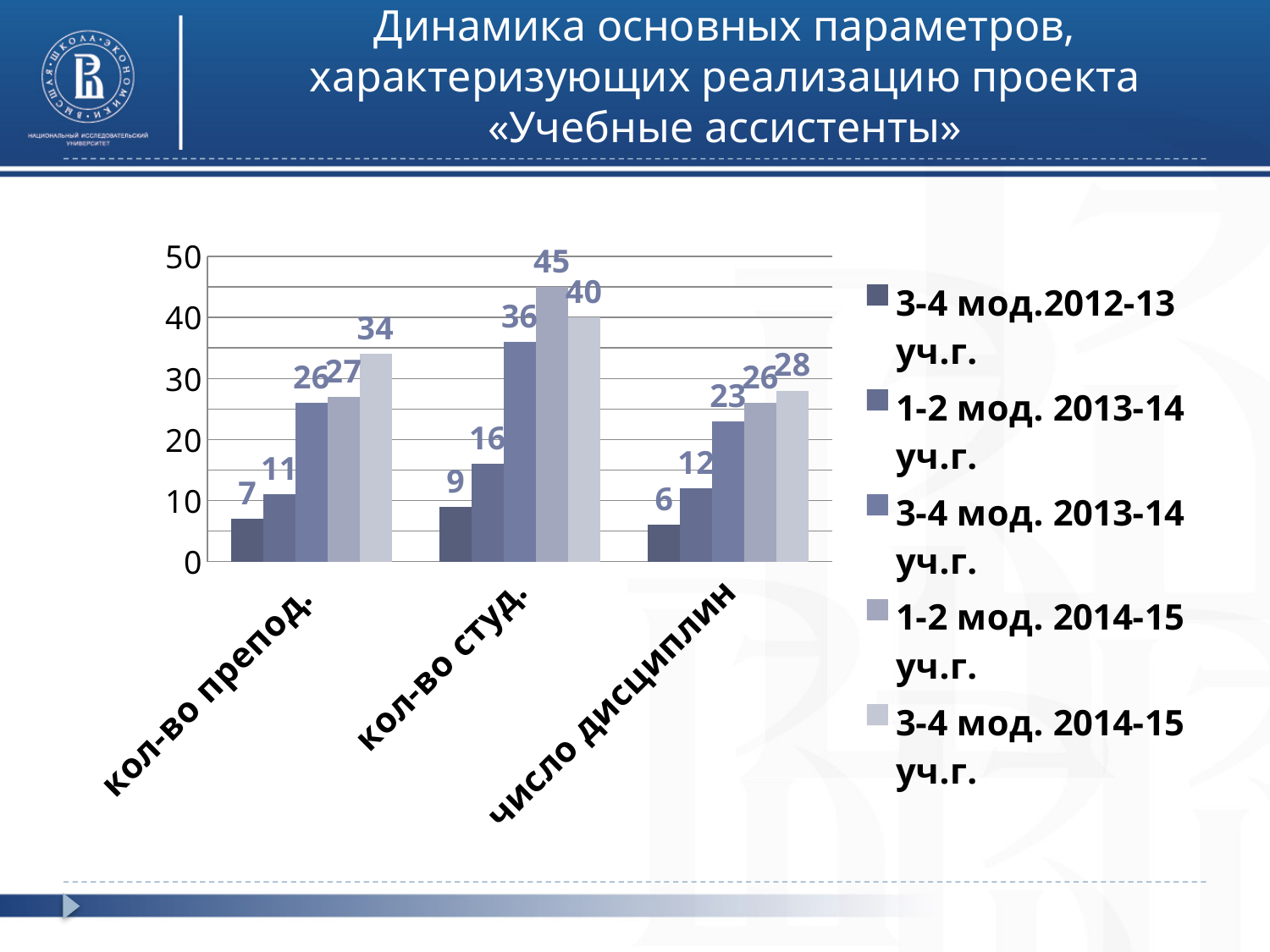
What is the value for «кол-во препод.» in the series «3-4 мод. 2014-15 уч.г.»? 34 Which category has the lowest value in the series «1-2 мод. 2013-14 уч.г.»? кол-во препод. For «число дисциплин», which is larger: the value for «3-4 мод. 2013-14 уч.г.» or for «1-2 мод. 2013-14 уч.г.»? 3-4 мод. 2013-14 уч.г. Which category has the highest value in the series «3-4 мод. 2013-14 уч.г.»? кол-во студ. Is the value for «кол-во студ.» in the series «3-4 мод. 2013-14 уч.г.» greater or less than 30? greater What type of chart is shown on the slide? bar chart What is the value for «число дисциплин» in the series «3-4 мод.2012-13 уч.г.»? 6 What is the value for «кол-во студ.» in the series «1-2 мод. 2014-15 уч.г.»? 45 How many series does the legend list? 5 How many categories are shown on the x axis? 3 Do the values for «кол-во препод.» rise or fall from the series «3-4 мод.2012-13 уч.г.» to «3-4 мод. 2014-15 уч.г.»? rise What is the difference between the «1-2 мод. 2014-15 уч.г.» and «3-4 мод. 2014-15 уч.г.» values for «кол-во студ.»? 5